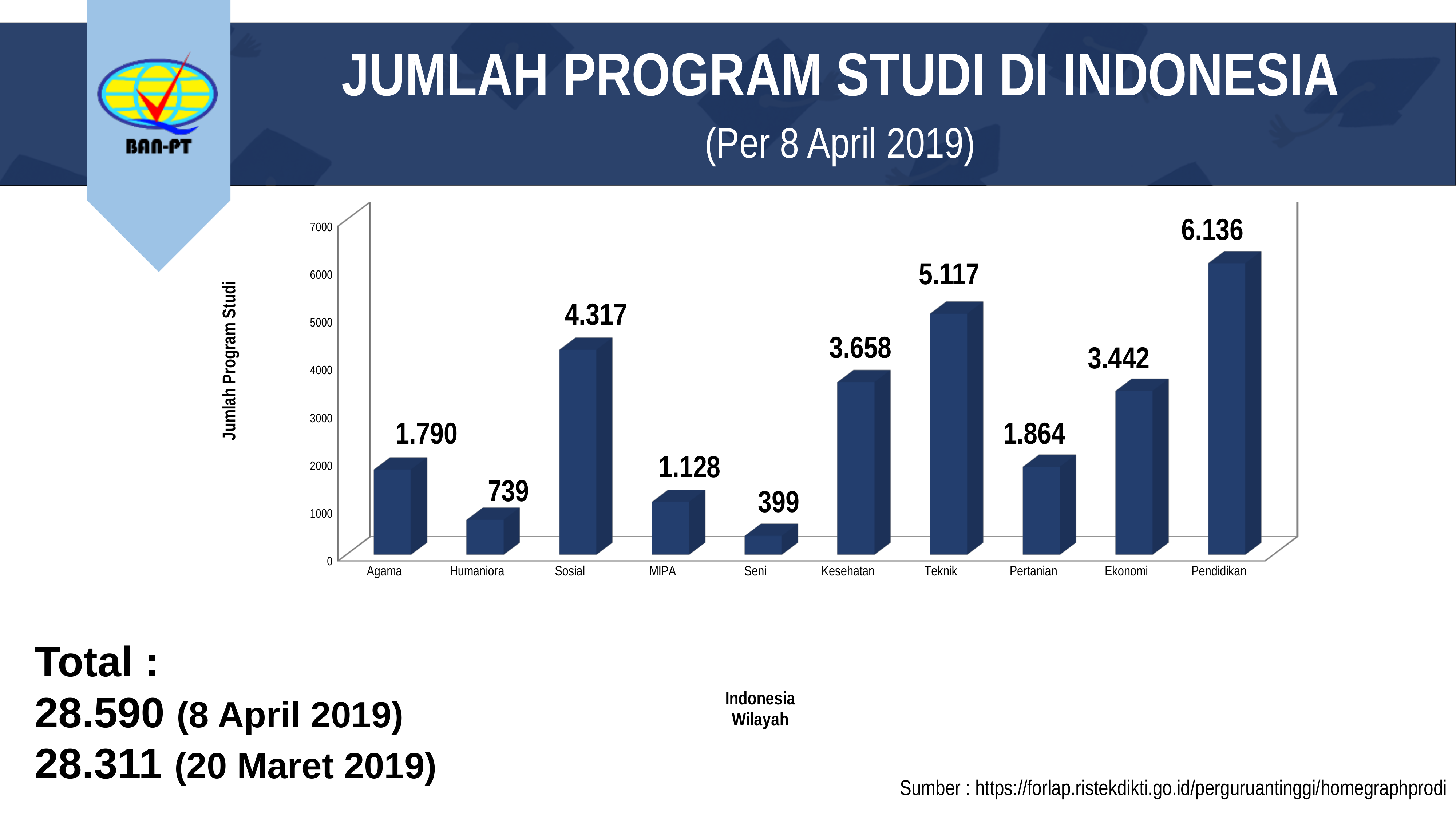
What is the difference between the values for Pendidikan and Teknik? 1.019 How many categories are shown on the x axis? 10 What is the value for Kesehatan? 3.658 Which category has the highest value? Pendidikan What is the value for Seni? 399 What is the label of the vertical axis? Jumlah Program Studi What kind of chart is shown on the slide? bar chart What is the value for Teknik? 5.117 Which is larger, the value for Ekonomi or the value for Sosial? Sosial Is the value for Humaniora greater or less than 1000? less Which category has the lowest value? Seni What is the difference between the values for Sosial and Kesehatan? 659